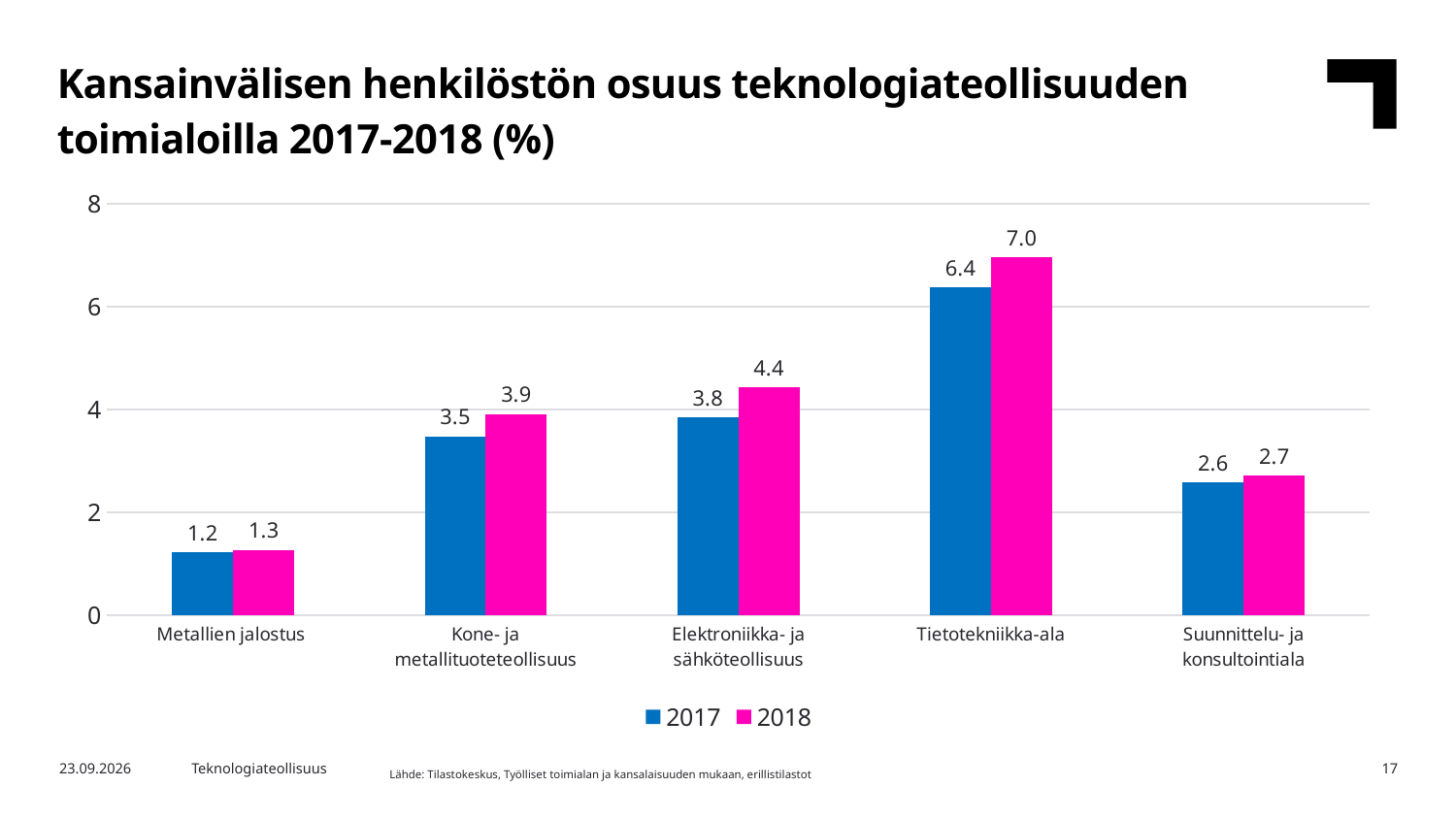
How many categories are shown on the x axis? 5 What is the difference between the 2018 and 2017 values for Tietotekniikka-ala? 0.6 What is the value for Metallien jalostus in 2017? 1.2 Which category has the highest value in 2017? Tietotekniikka-ala What is the 2018 value for Elektroniikka- ja sähköteollisuus? 4.4 What kind of chart is shown on the slide? Bar chart Is the 2017 value for Tietotekniikka-ala greater or less than 6? greater What is the value for Tietotekniikka-ala in 2018? 7.0 Which category has the lowest value in 2018? Metallien jalostus Which colour represents the 2018 series? Magenta (pink) Which is larger: the 2018 value for Kone- ja metallituoteteollisuus or the 2018 value for Suunnittelu- ja konsultointiala? Kone- ja metallituoteteollisuus How many series does the legend list? 2